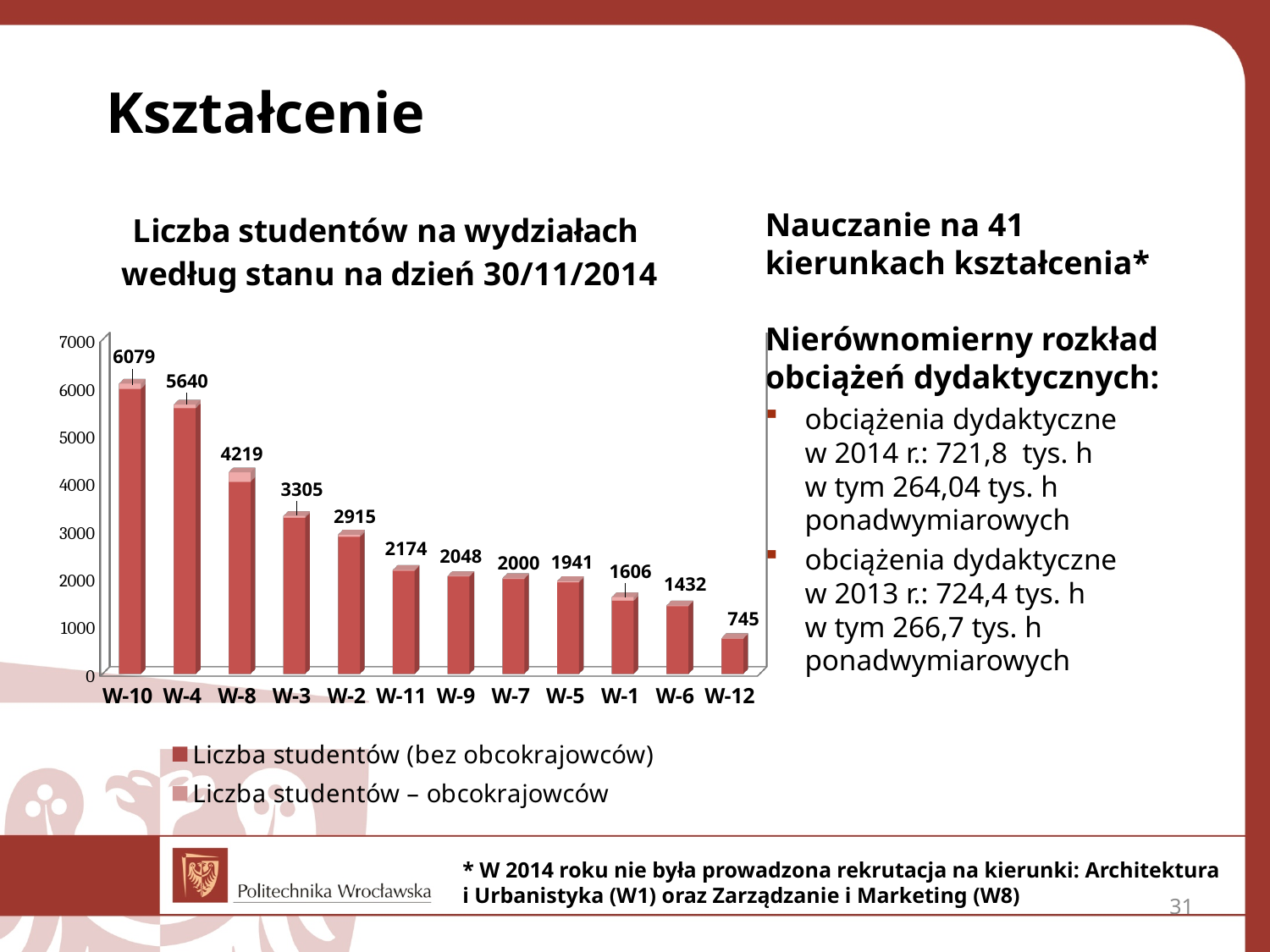
What is the difference between the labelled values for W-10 and W-4? 439 Is the labelled value for W-11 greater or less than 2000? greater What value is labelled above the bar for W-3? 3305 What value is labelled above the bar for W-10? 6079 How many faculties (categories) are shown on the x axis of the chart? 12 Which faculty has the highest labelled value in the chart? W-10 What value is labelled above the bar for W-12? 745 Which has a larger labelled value, W-8 or W-2? W-8 Do the labelled values rise or fall moving from left to right along the x axis? Fall Which faculty has the lowest labelled value in the chart? W-12 How many series does the chart legend list? 2 What kind of chart is shown on the slide? Bar chart